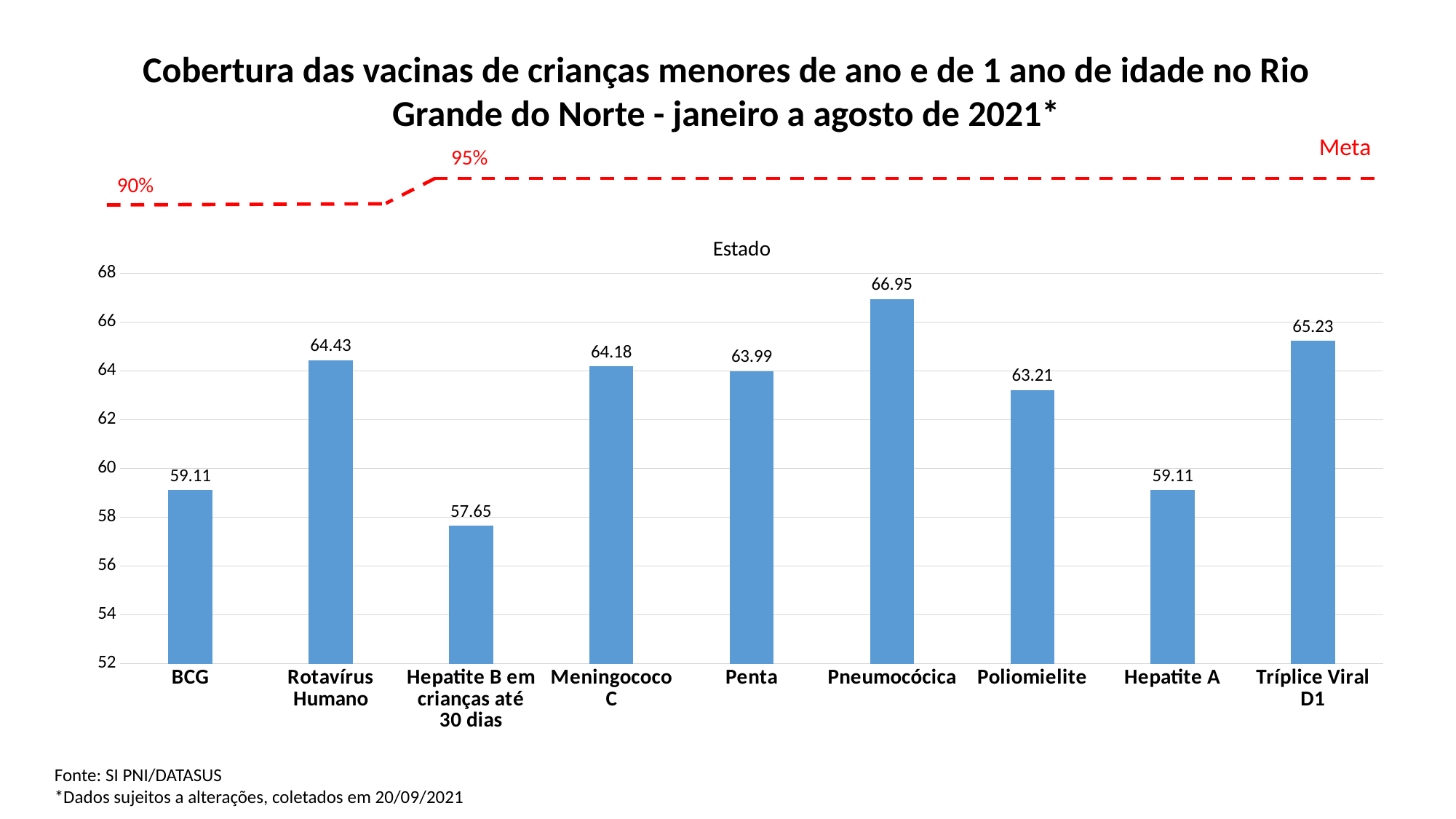
What kind of chart is shown on the slide? bar chart Is the value for BCG greater or less than 60? less Which vaccine has the lowest coverage value? Hepatite B em crianças até 30 dias How many vaccine categories are shown on the chart? 9 What is the value for Tríplice Viral D1? 65.23 What is the difference between the values for Pneumocócica and Hepatite B em crianças até 30 dias? 9.30 What is the value for Pneumocócica? 66.95 What is the value for Hepatite B em crianças até 30 dias? 57.65 What is the difference between the values for Rotavírus Humano and Penta? 0.44 Which is larger, the value for Tríplice Viral D1 or the value for Poliomielite? Tríplice Viral D1 Which vaccine has the highest coverage value? Pneumocócica What is the value for Poliomielite? 63.21